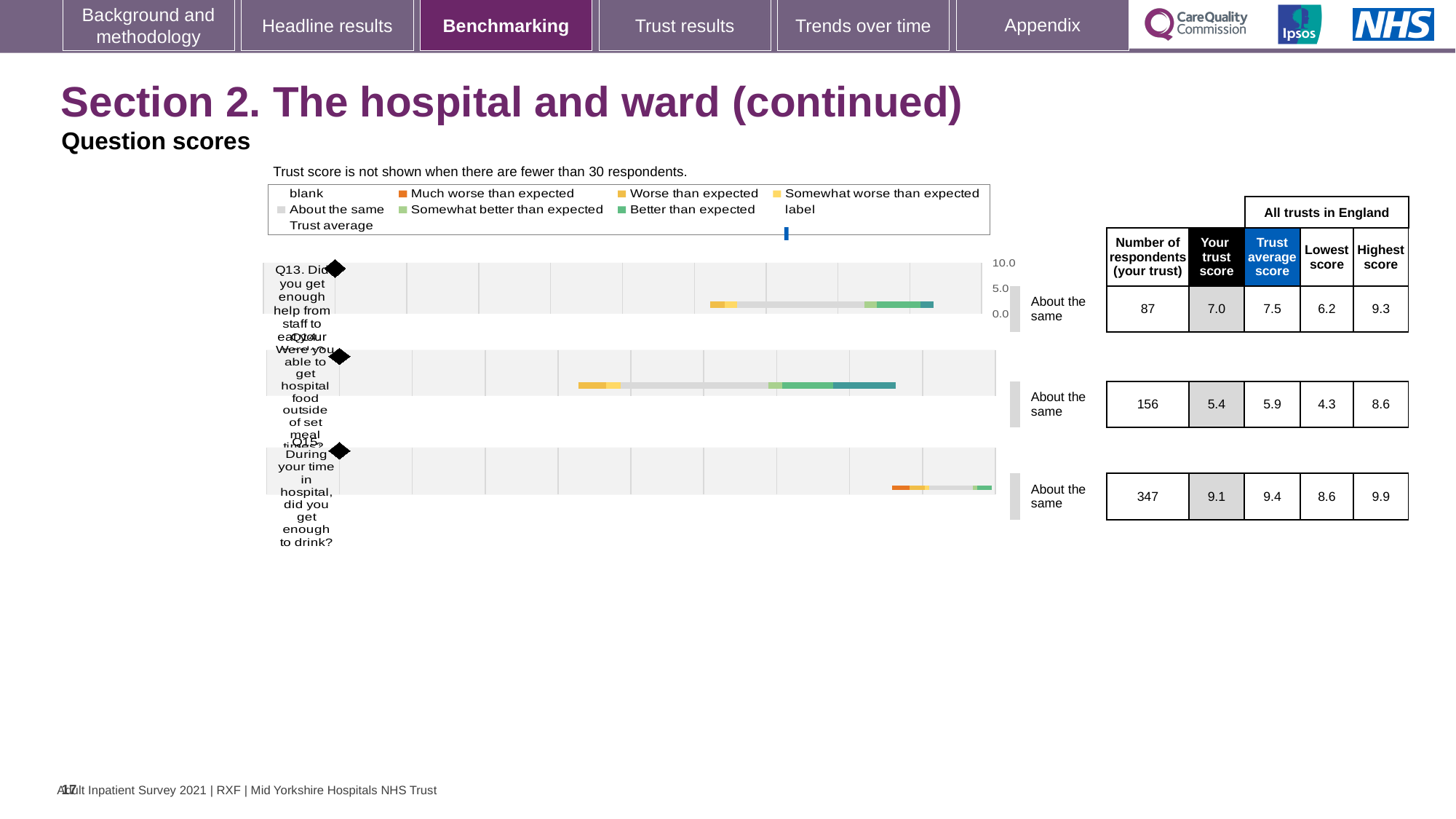
What is the 'Your trust score' for Q13 (Did you get enough help from staff to eat your meals)? 7.0 Which question has the highest 'Your trust score'? Q15 What kind of chart is used to show the question scores on this slide? Bar chart Which question has the lowest 'Your trust score'? Q14 What benchmark category is shown for Q14 next to the chart? About the same How many respondents from your trust answered Q15 (did you get enough to drink)? 347 What is the trust average score across all trusts in England for Q14 (hospital food outside of set meal times)? 5.9 How many questions are plotted in the chart on this slide? 3 By how much is the trust average score higher than your trust score for Q14? 0.5 For Q13, which is larger: your trust score or the trust average score? Trust average score (7.5) According to the note above the chart, when is the trust score not shown? When there are fewer than 30 respondents What is the difference between the highest score and the lowest score for Q15? 1.3